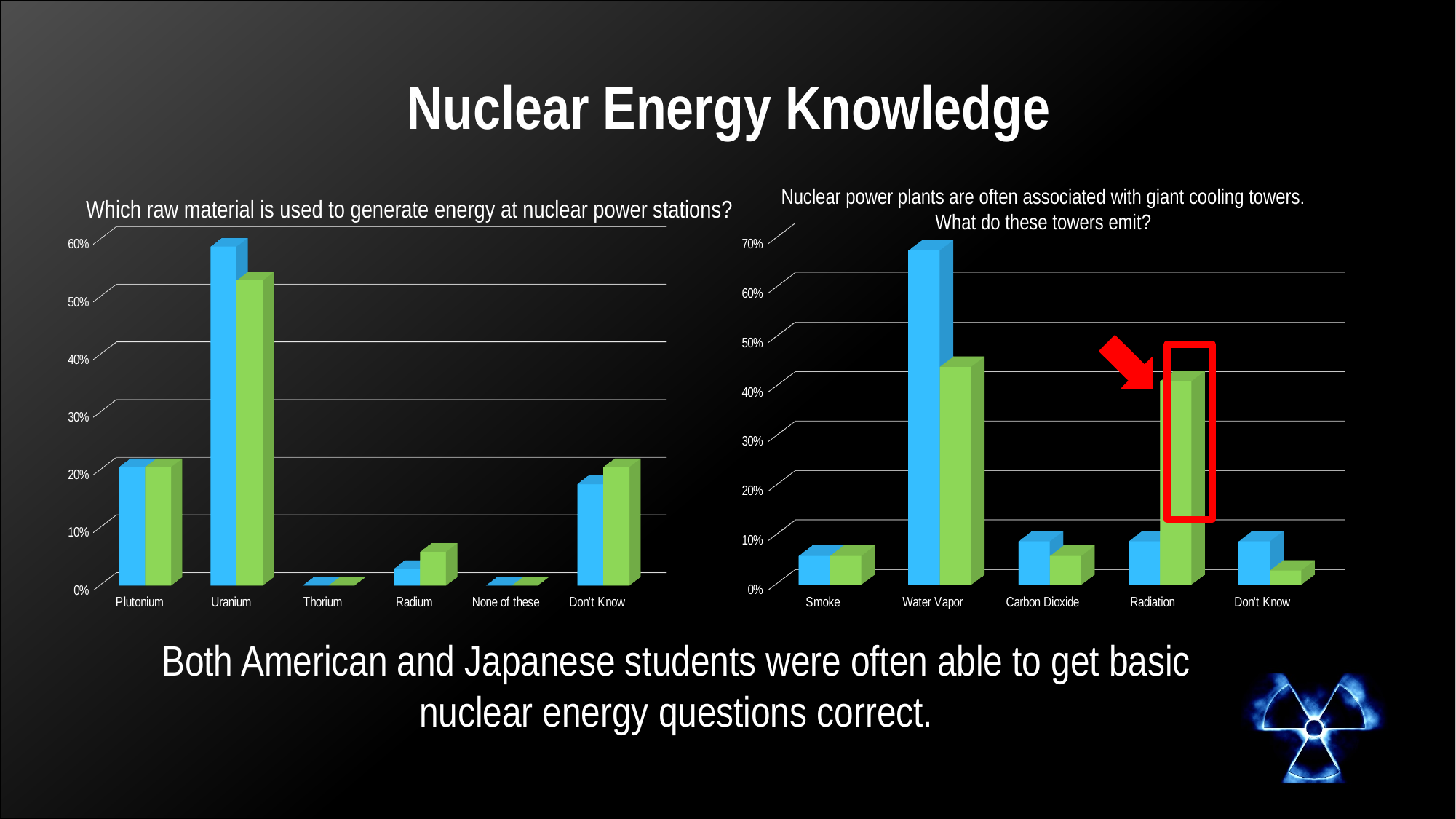
In the left chart about raw materials, is the blue bar for Uranium greater or less than 50%? greater What kind of chart is the left chart, titled 'Which raw material is used to generate energy at nuclear power stations?'? Bar chart In the right chart about cooling towers, is the green bar for Radiation greater or less than 30%? greater How many categories are shown on the x axis of the left chart about raw materials? 6 In the left chart about raw materials, is the blue bar for Plutonium greater or less than 30%? less In the left chart about raw materials, which category has the highest bars? Uranium In the right chart about cooling towers, which category's bar is outlined with a red box? Radiation How many categories are shown on the x axis of the right chart about cooling towers? 5 In the left chart about raw materials, which is larger: the blue bar for Uranium or the blue bar for Don't Know? The blue bar for Uranium In the right chart about cooling towers, which is larger for Radiation: the blue bar or the green bar? The green bar In the right chart about cooling towers, which category has the tallest bar? Water Vapor